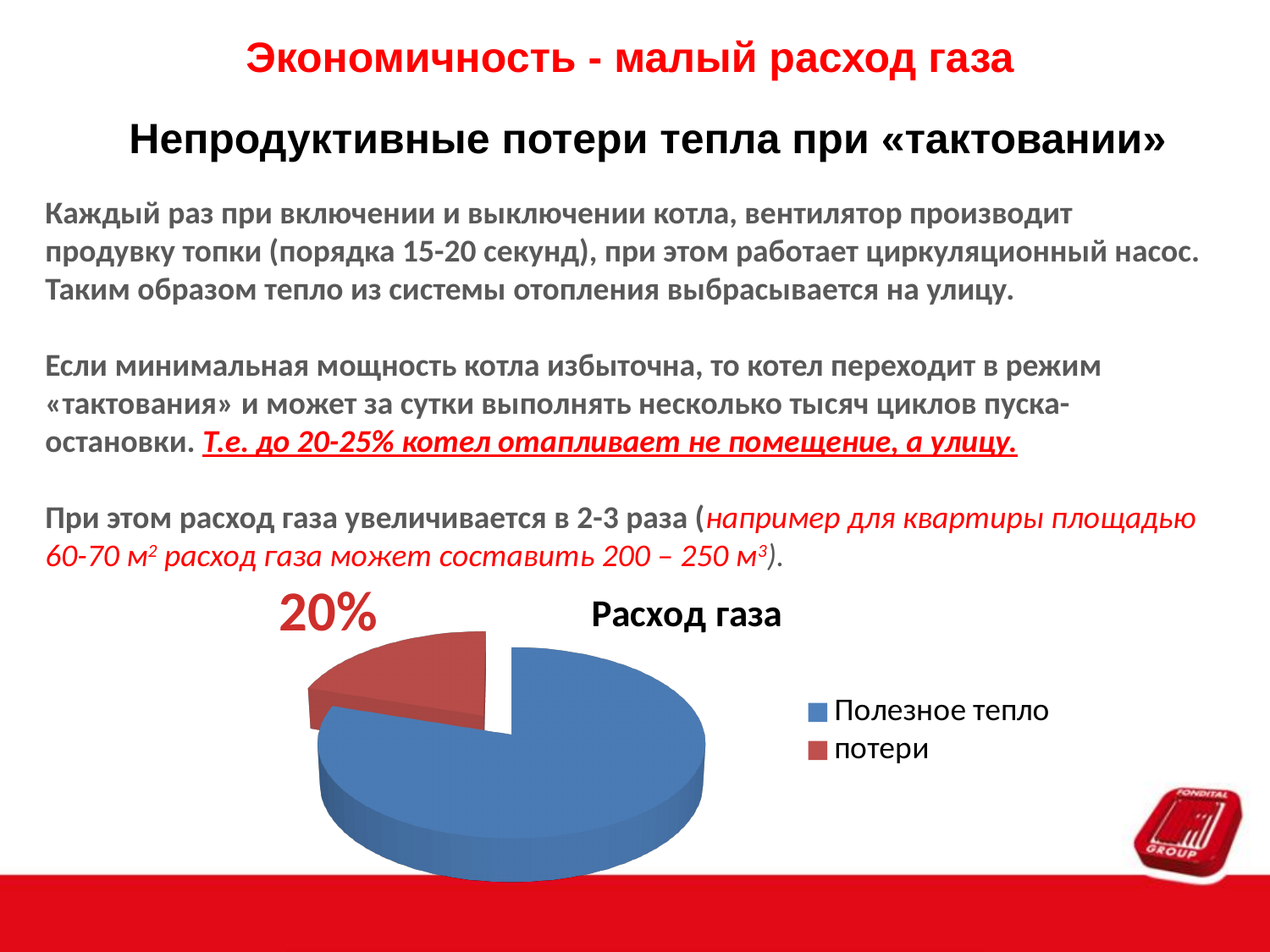
Which slice of the pie chart is the largest? Полезное тепло What colour is the Полезное тепло slice in the pie chart? blue Which is larger in the pie chart, Полезное тепло or потери? Полезное тепло How many entries does the chart legend list? 2 How many slices does the pie chart have? 2 What share of the pie does the потери slice represent, according to the label on the slide? 20% Which slice of the pie chart is the smallest? потери What kind of chart is shown on the slide? pie chart What is the title of the chart? Расход газа